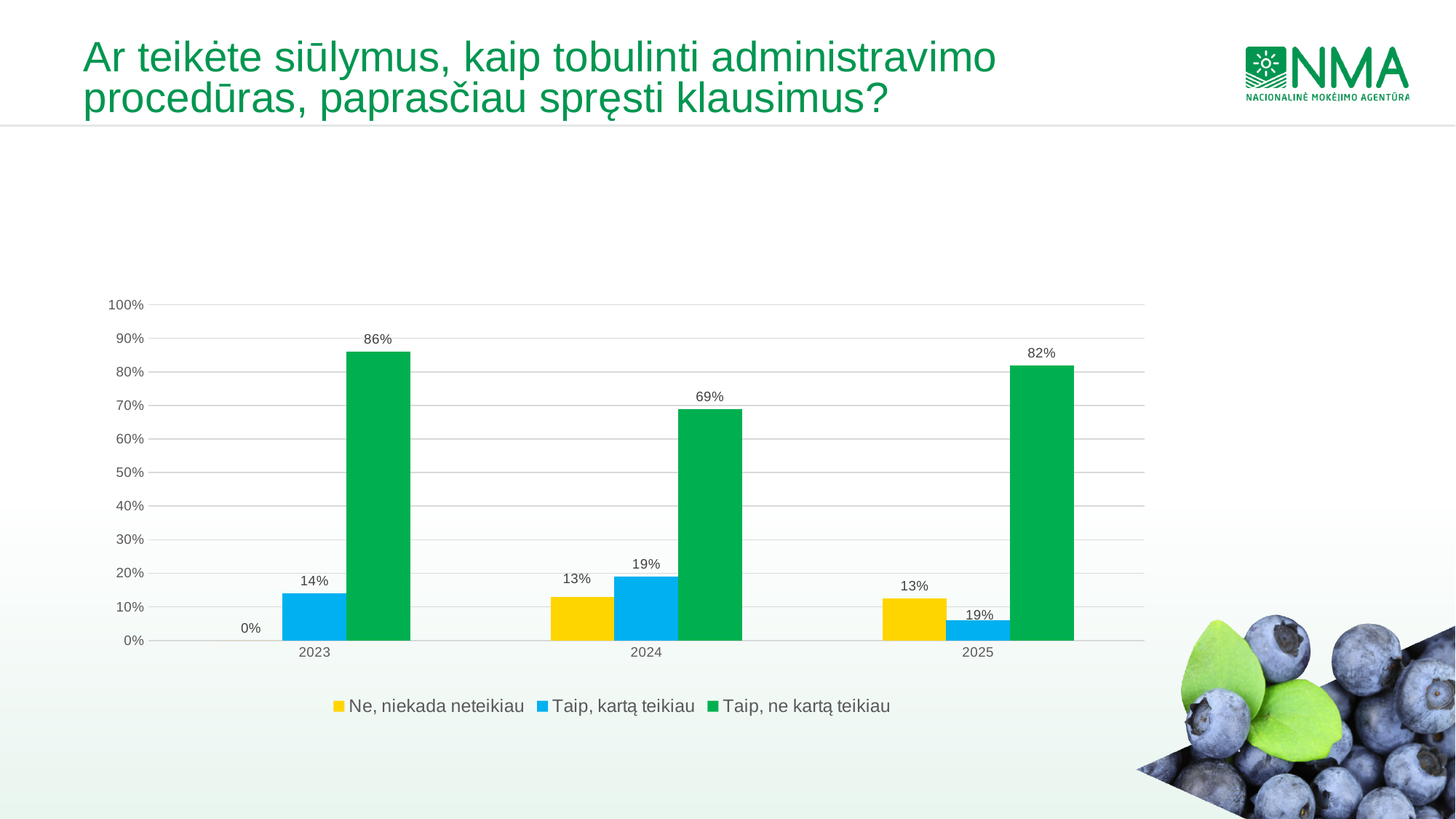
What is the value for "Taip, ne kartą teikiau" in 2023? 86% Which is larger: "Taip, kartą teikiau" in 2023 or "Taip, kartą teikiau" in 2024? 2024 What kind of chart is shown on the slide? bar chart What is the value for "Taip, kartą teikiau" in 2023? 14% What is the value for "Ne, niekada neteikiau" in 2024? 13% What is the value for "Taip, ne kartą teikiau" in 2024? 69% What is the difference between the "Taip, ne kartą teikiau" values for 2023 and 2024? 17% How many series does the legend list? 3 What is the value for "Ne, niekada neteikiau" in 2023? 0% How many years are shown on the x axis? 3 What is the value for "Taip, ne kartą teikiau" in 2025? 82% In which year is the value for "Taip, ne kartą teikiau" lowest? 2024